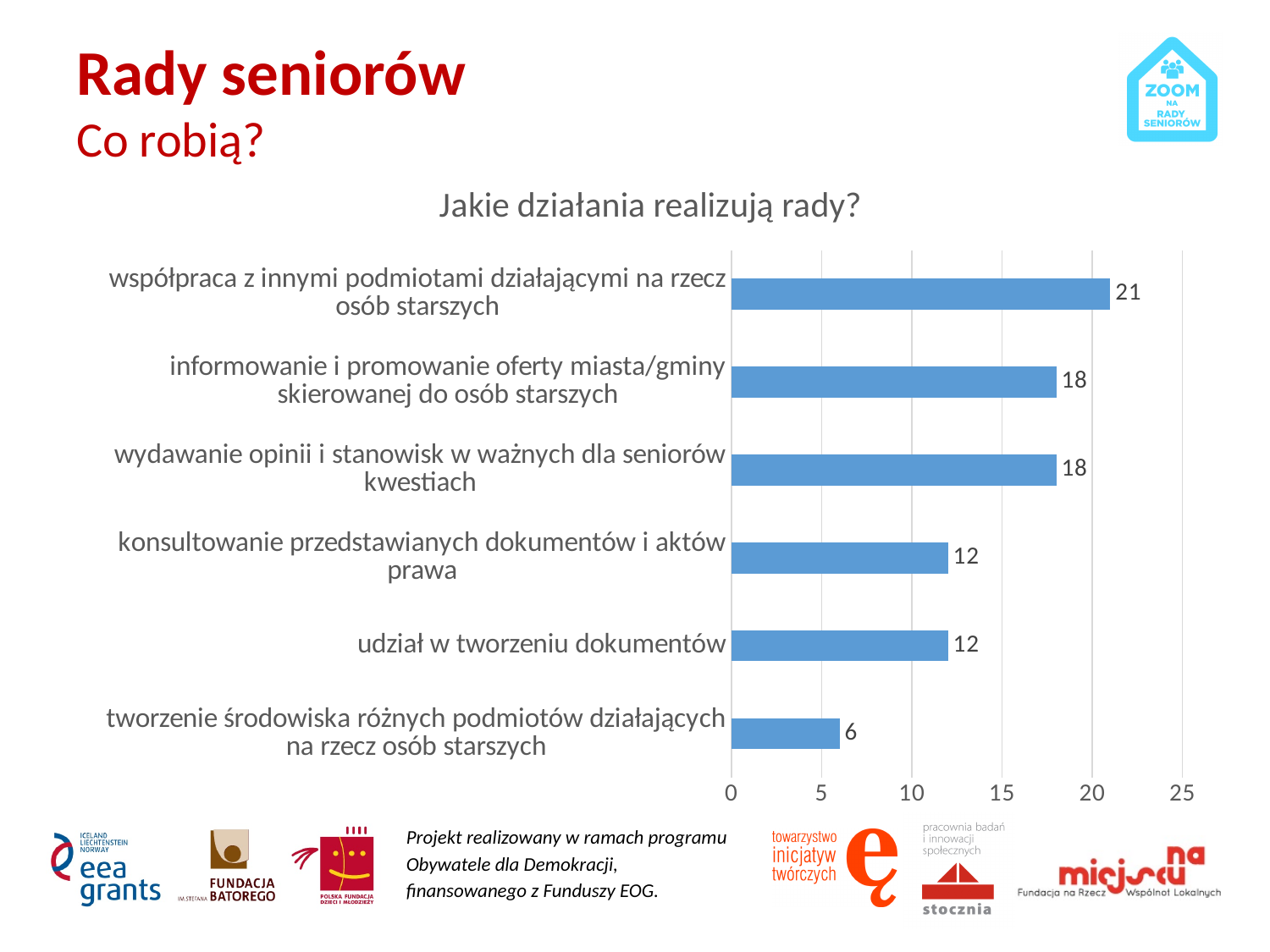
Which category has the highest value? współpraca z innymi podmiotami działającymi na rzecz osób starszych What kind of chart is shown on the slide? bar chart What is the value for 'tworzenie środowiska różnych podmiotów działających na rzecz osób starszych'? 6 What is the value for 'informowanie i promowanie oferty miasta/gminy skierowanej do osób starszych'? 18 What is the value for 'współpraca z innymi podmiotami działającymi na rzecz osób starszych'? 21 What is the title of the chart? Jakie działania realizują rady? Which category has the lowest value? tworzenie środowiska różnych podmiotów działających na rzecz osób starszych What is the difference between the values for 'wydawanie opinii i stanowisk w ważnych dla seniorów kwestiach' and 'udział w tworzeniu dokumentów'? 6 How many categories are shown in the chart? 6 What is the value for 'konsultowanie przedstawianych dokumentów i aktów prawa'? 12 What is the difference between the values for 'współpraca z innymi podmiotami działającymi na rzecz osób starszych' and 'tworzenie środowiska różnych podmiotów działających na rzecz osób starszych'? 15 Which is larger: the value for 'informowanie i promowanie oferty miasta/gminy skierowanej do osób starszych' or the value for 'udział w tworzeniu dokumentów'? informowanie i promowanie oferty miasta/gminy skierowanej do osób starszych